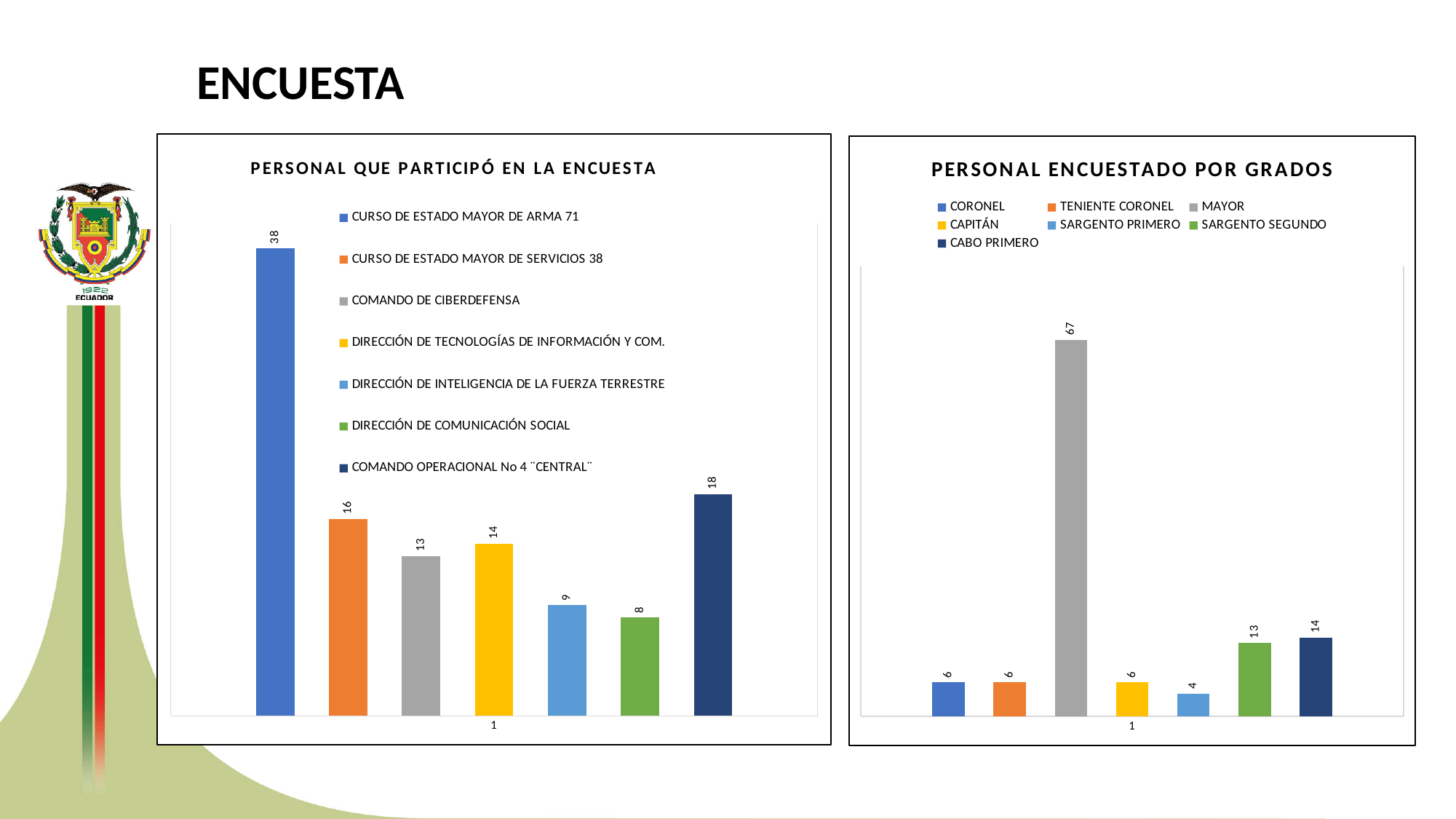
In the chart titled "PERSONAL QUE PARTICIPÓ EN LA ENCUESTA", what is the value for DIRECCIÓN DE INTELIGENCIA DE LA FUERZA TERRESTRE? 9 What kind of chart is the one titled "PERSONAL ENCUESTADO POR GRADOS"? Bar chart In the chart titled "PERSONAL ENCUESTADO POR GRADOS", which series has the lowest value? SARGENTO PRIMERO In the chart titled "PERSONAL ENCUESTADO POR GRADOS", what is the value for MAYOR? 67 In the chart titled "PERSONAL QUE PARTICIPÓ EN LA ENCUESTA", what is the difference between CURSO DE ESTADO MAYOR DE ARMA 71 and COMANDO OPERACIONAL No 4 ¨CENTRAL¨? 20 In the chart titled "PERSONAL ENCUESTADO POR GRADOS", what is the difference between CABO PRIMERO and SARGENTO SEGUNDO? 1 In the chart titled "PERSONAL QUE PARTICIPÓ EN LA ENCUESTA", which is larger: CURSO DE ESTADO MAYOR DE SERVICIOS 38 or DIRECCIÓN DE TECNOLOGÍAS DE INFORMACIÓN Y COM.? CURSO DE ESTADO MAYOR DE SERVICIOS 38 In the chart titled "PERSONAL ENCUESTADO POR GRADOS", what is the value for CAPITÁN? 6 In the chart titled "PERSONAL ENCUESTADO POR GRADOS", which series has the highest value? MAYOR In the chart titled "PERSONAL QUE PARTICIPÓ EN LA ENCUESTA", how many series does the legend list? 7 In the chart titled "PERSONAL QUE PARTICIPÓ EN LA ENCUESTA", what is the value for CURSO DE ESTADO MAYOR DE ARMA 71? 38 In the chart titled "PERSONAL QUE PARTICIPÓ EN LA ENCUESTA", which series has the lowest value? DIRECCIÓN DE COMUNICACIÓN SOCIAL